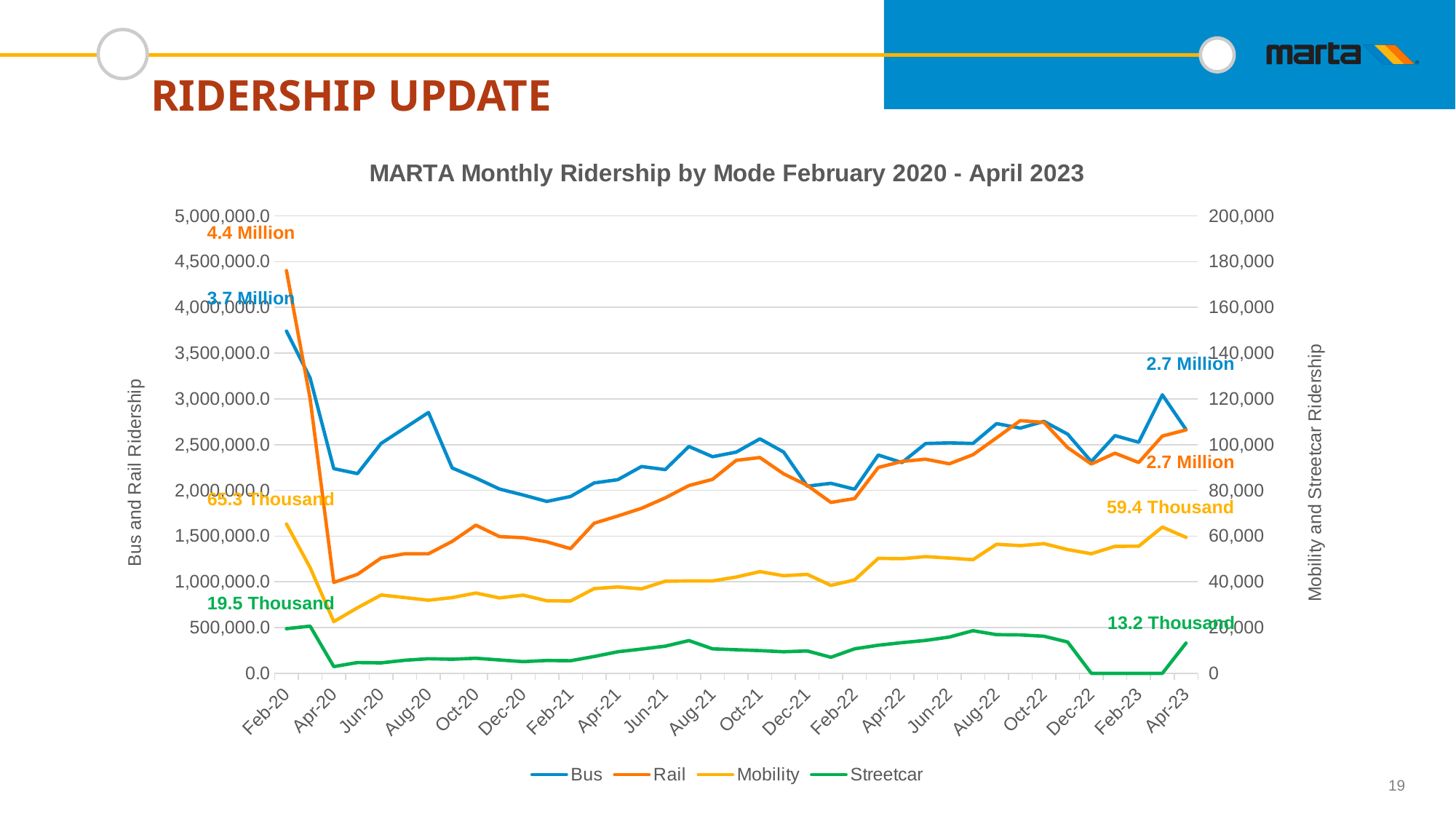
What is the difference between the labelled Streetcar values at Feb-20 and Apr-23? 6.3 Thousand What is the labelled Mobility ridership value at Apr-23? 59.4 Thousand Which is larger at Feb-20, the Bus value or the Rail value? Rail What is the labelled Streetcar ridership value at Feb-20? 19.5 Thousand What is the labelled Bus ridership value at Feb-20? 3.7 Million What kind of chart is shown on the slide? Line chart What is the title of the chart? MARTA Monthly Ridership by Mode February 2020 - April 2023 How many series does the legend list? 4 What is the difference between the labelled Rail and Bus values at Feb-20? 0.7 Million Which series has the highest labelled value at Feb-20? Rail Is the Bus value at Apr-20 greater or less than 2,500,000.0? less What is the labelled Rail ridership value at Feb-20? 4.4 Million